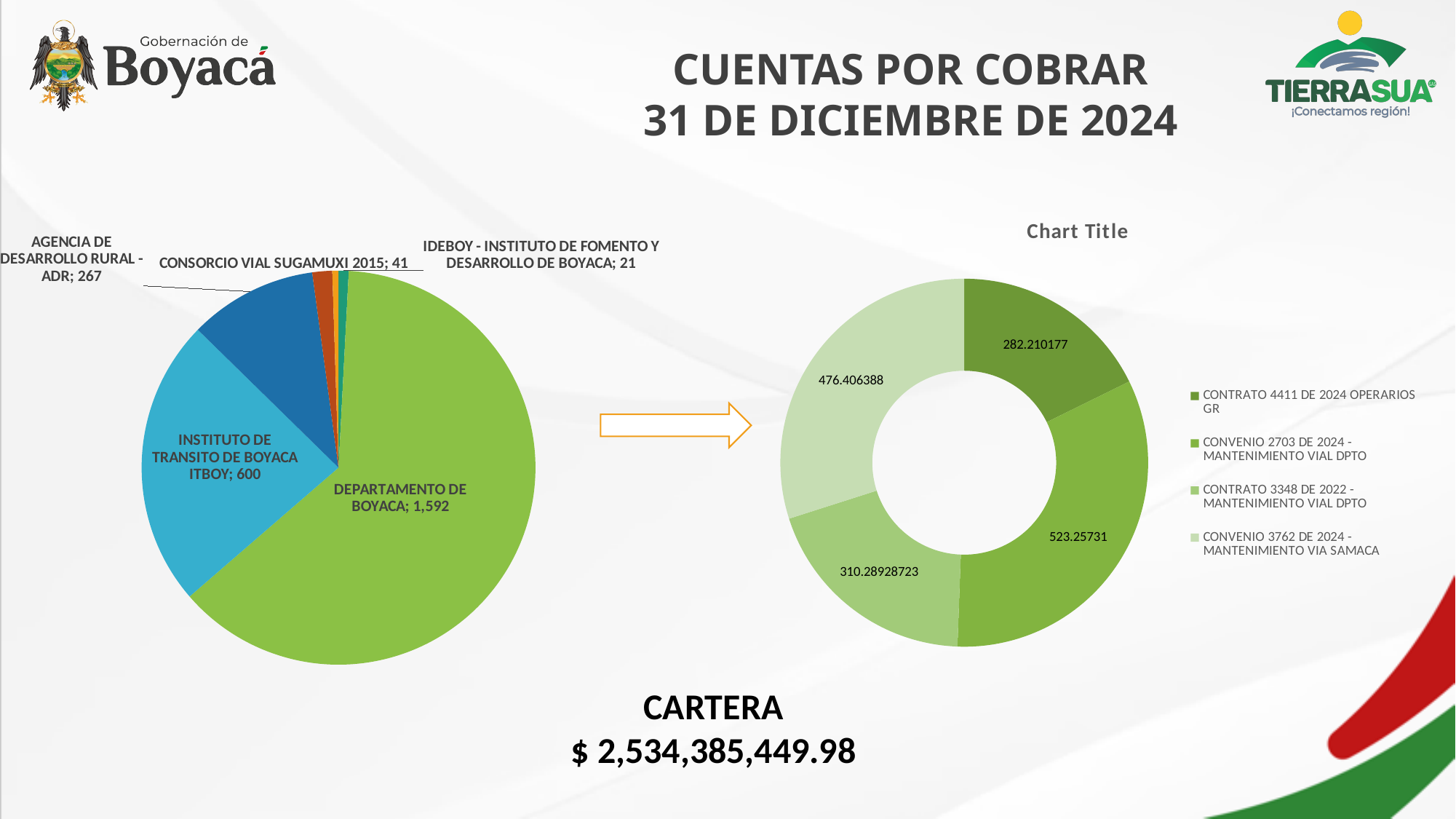
In the right doughnut chart titled 'Chart Title', what is the value for CONVENIO 2703 DE 2024 - MANTENIMIENTO VIAL DPTO? 523.25731 In the left pie chart, what is the value for DEPARTAMENTO DE BOYACA? 1,592 In the right doughnut chart titled 'Chart Title', which category has the smallest value? CONTRATO 4411 DE 2024 OPERARIOS GR In the left pie chart, what is the value for AGENCIA DE DESARROLLO RURAL - ADR? 267 In the left pie chart, what is the difference between the values for DEPARTAMENTO DE BOYACA and INSTITUTO DE TRANSITO DE BOYACA ITBOY? 992 In the left pie chart, what is the value for INSTITUTO DE TRANSITO DE BOYACA ITBOY? 600 In the right doughnut chart titled 'Chart Title', what is the value for CONTRATO 4411 DE 2024 OPERARIOS GR? 282.210177 In the right doughnut chart titled 'Chart Title', what is the difference between the values for CONVENIO 2703 DE 2024 - MANTENIMIENTO VIAL DPTO and CONTRATO 4411 DE 2024 OPERARIOS GR? 241.047133 In the left pie chart, which category has the largest value? DEPARTAMENTO DE BOYACA In the left pie chart, which is larger: CONSORCIO VIAL SUGAMUXI 2015 or IDEBOY - INSTITUTO DE FOMENTO Y DESARROLLO DE BOYACA? CONSORCIO VIAL SUGAMUXI 2015 In the right doughnut chart titled 'Chart Title', how many entries does the legend list? 4 What kind of chart is the chart on the left of the slide? Pie chart